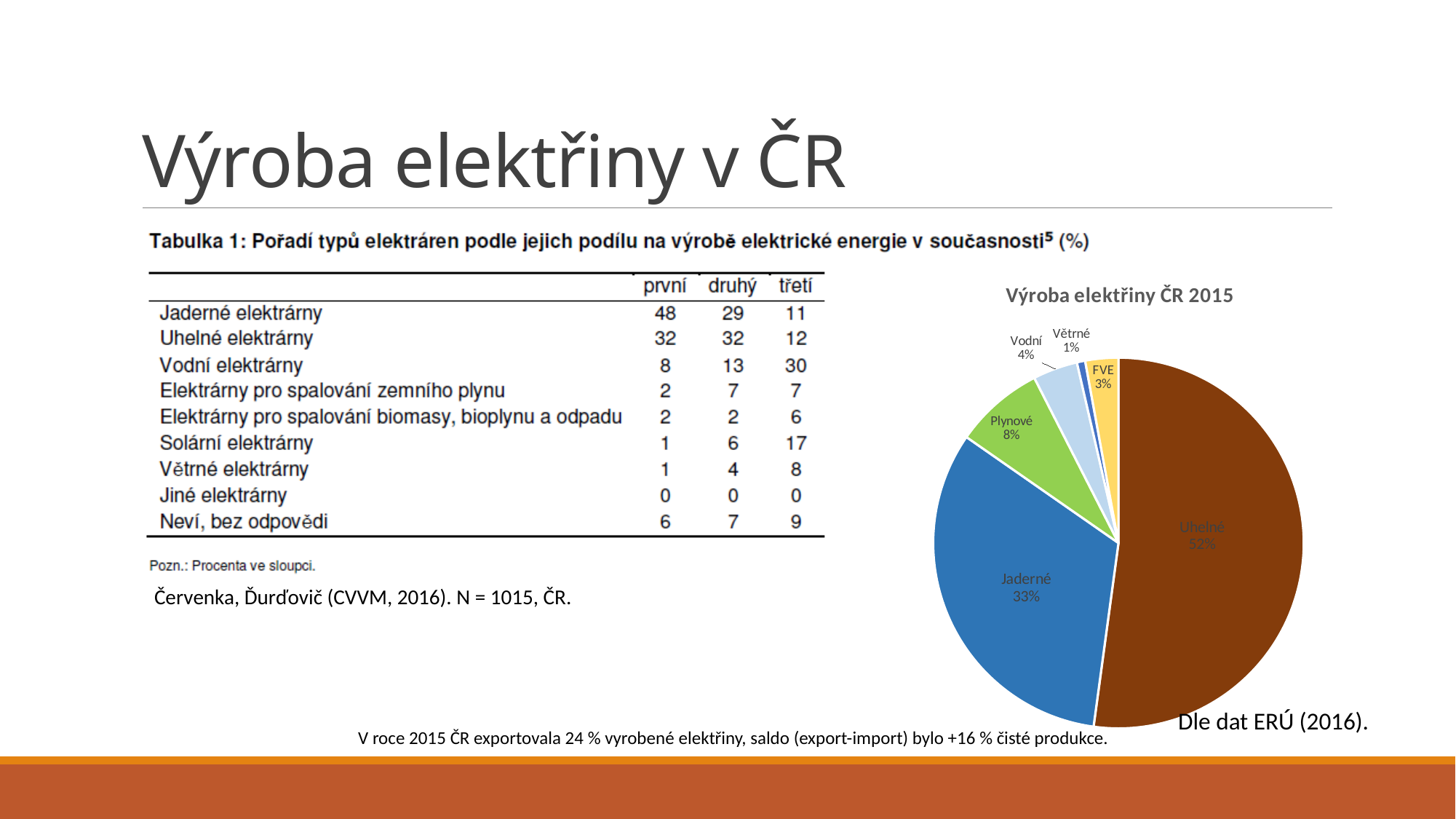
How many slices does the pie chart have? 6 What is the value shown for Vodní in the pie chart? 4% What is the value shown for FVE in the pie chart? 3% What share of the pie chart does Jaderné have? 33% What is the value shown for Plynové in the pie chart? 8% Which is larger in the pie chart, Plynové or Vodní? Plynové Which category has the smallest slice in the pie chart? Větrné What share of the pie chart does Uhelné have? 52% Which category has the largest slice in the pie chart? Uhelné What is the title of the pie chart? Výroba elektřiny ČR 2015 What kind of chart is shown on the slide? pie chart What is the difference in percentage points between Uhelné and Jaderné in the pie chart? 19